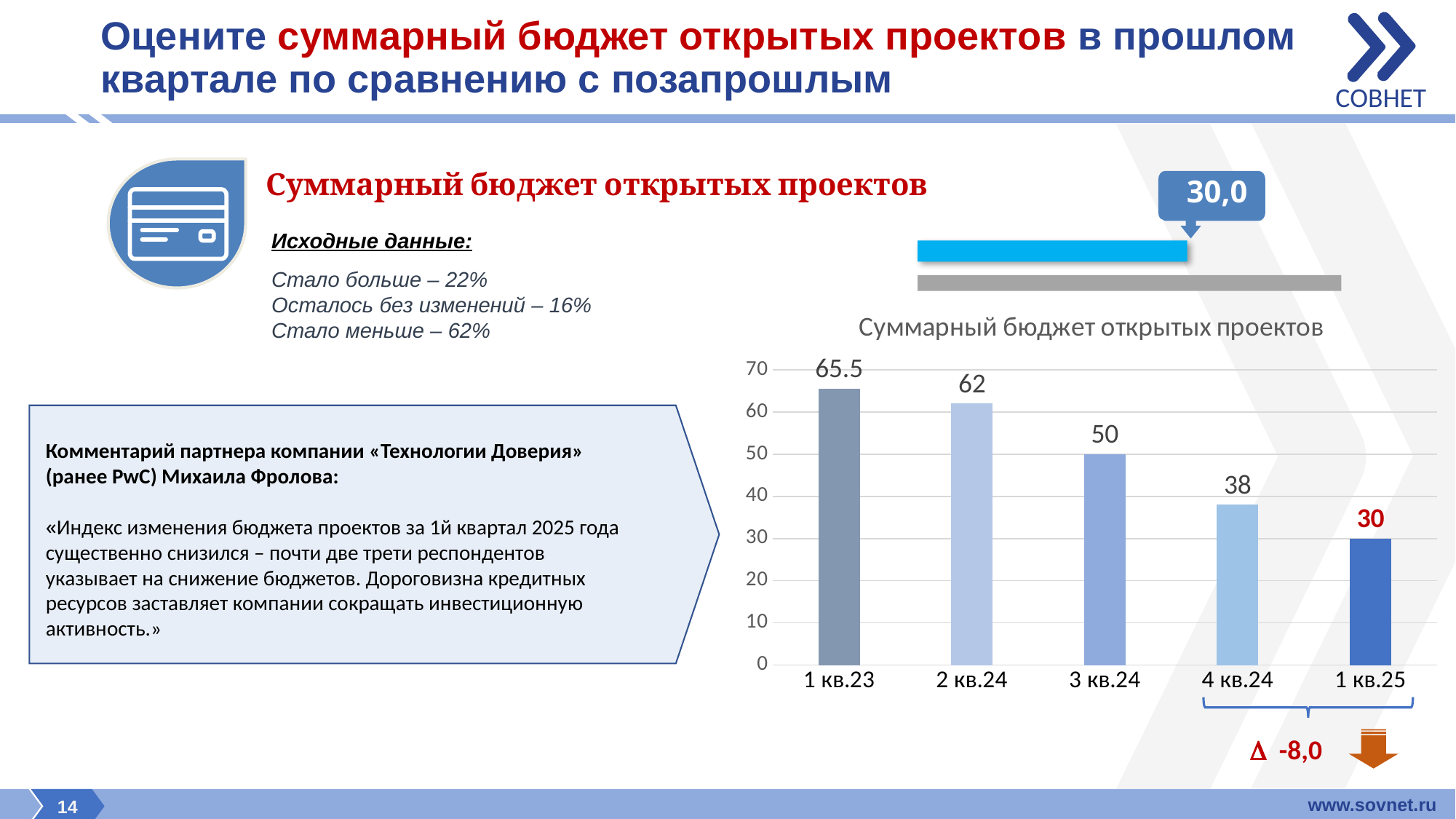
How many categories are shown on the x axis of the chart "Суммарный бюджет открытых проектов"? 5 What kind of chart is "Суммарный бюджет открытых проектов"? Bar chart What is the value for 1 кв.23 in the chart "Суммарный бюджет открытых проектов"? 65.5 Which category has the highest value in the chart "Суммарный бюджет открытых проектов"? 1 кв.23 What is the value for 3 кв.24 in the chart "Суммарный бюджет открытых проектов"? 50 Do the values in the chart "Суммарный бюджет открытых проектов" rise or fall from 1 кв.23 to 1 кв.25? Fall Which category has the lowest value in the chart "Суммарный бюджет открытых проектов"? 1 кв.25 What is the value for 1 кв.25 in the chart "Суммарный бюджет открытых проектов"? 30 What is the difference between the values for 2 кв.24 and 3 кв.24 in the chart "Суммарный бюджет открытых проектов"? 12 What is the title of the bar chart on the slide? Суммарный бюджет открытых проектов Which is larger in the chart "Суммарный бюджет открытых проектов": the value for 2 кв.24 or the value for 4 кв.24? 2 кв.24 What is the difference between the values for 4 кв.24 and 1 кв.25 in the chart "Суммарный бюджет открытых проектов"? 8